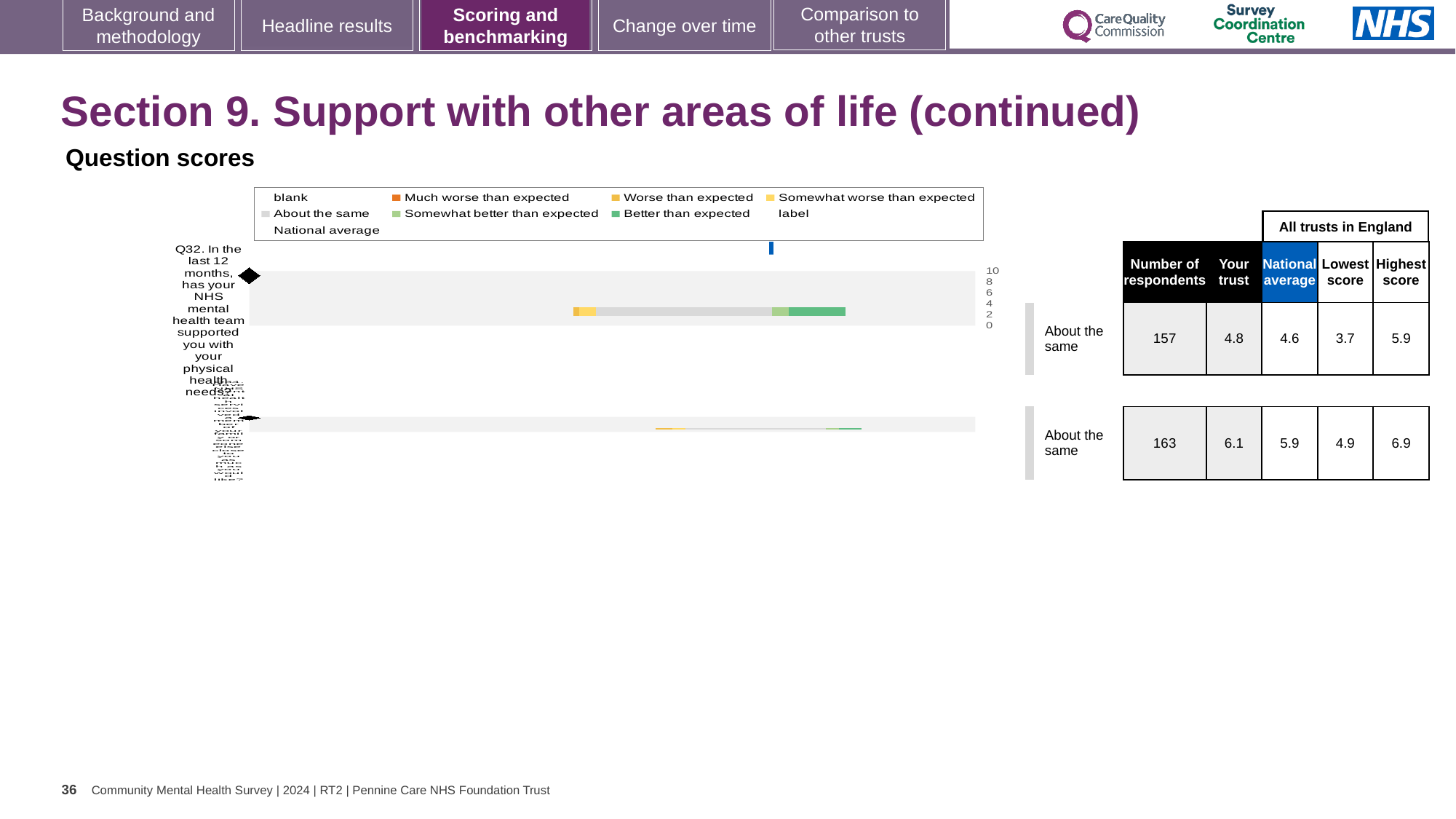
What benchmark category is shown next to the Q32 bar? About the same In the table beside the chart, what is the national average for Q32? 4.6 What colour does the legend use for 'Better than expected'? green In the table beside the chart, what is the 'Your trust' score for Q32? 4.8 What colour does the legend use for 'Much worse than expected'? orange In the table beside the chart, what is the 'Your trust' score in the second row? 6.1 How many question bars are plotted in the chart? 2 In the table beside the chart, what is the number of respondents for Q32? 157 For Q32, which is higher: the 'Your trust' score or the national average? Your trust How many entries does the chart legend list? 9 For Q32, what is the difference between the highest score and the lowest score in the table? 2.2 What kind of chart is shown under 'Question scores'? bar chart